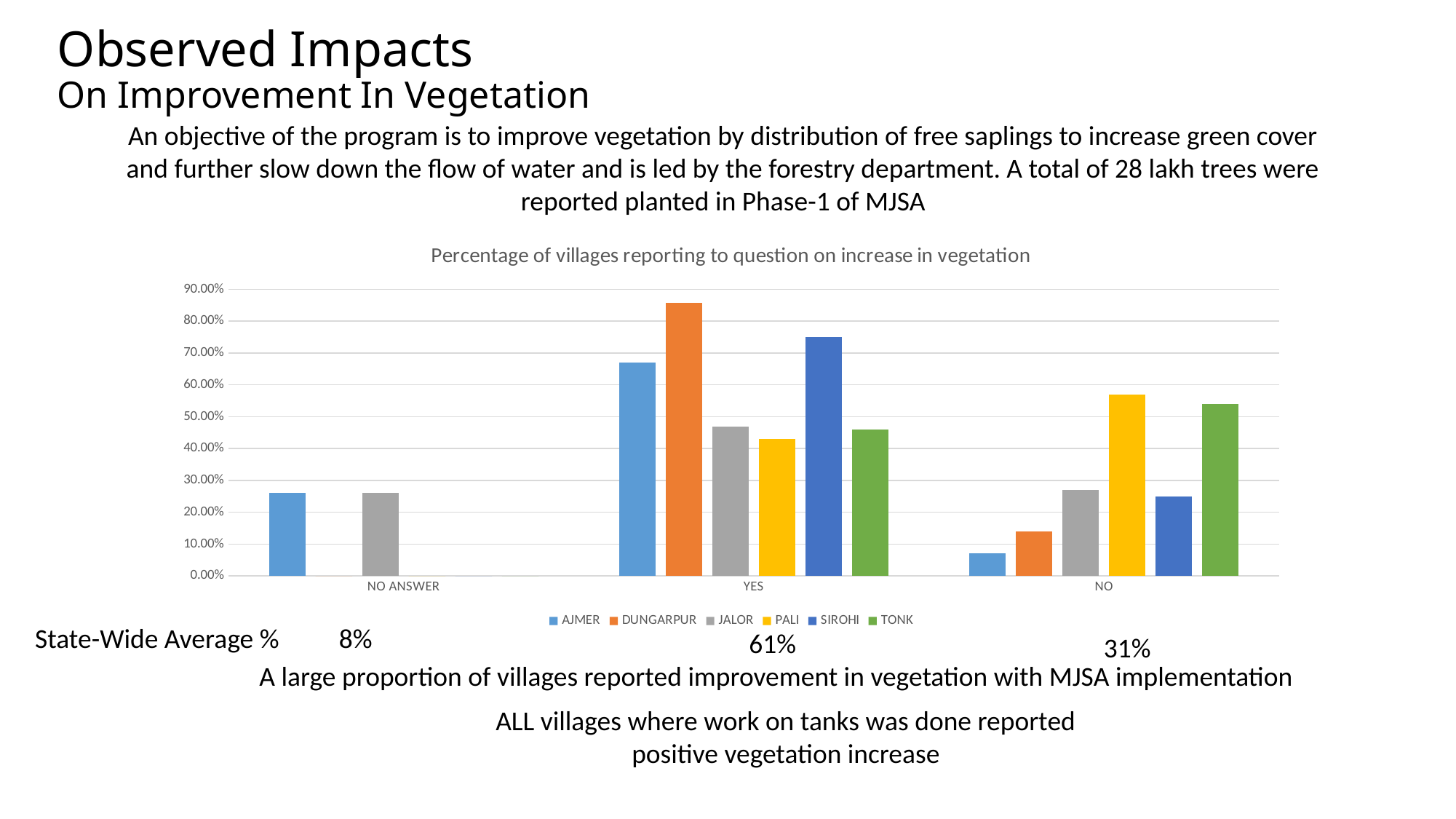
Is the value for JALOR in the YES category greater or less than 50.00%? less Which district has the lowest bar in the NO category? AJMER What kind of chart is shown on the slide? Bar chart Which district has the highest bar in the YES category? DUNGARPUR In the NO category, which is larger: the value for PALI or the value for DUNGARPUR? PALI How many response categories are shown on the x axis of the chart? 3 What is the title of the chart? Percentage of villages reporting to question on increase in vegetation Is the value for AJMER in the NO ANSWER category greater or less than 30.00%? less How many series does the legend of the chart list? 6 Is the value for DUNGARPUR in the YES category greater or less than 80.00%? greater In the YES category, which is larger: the value for AJMER or the value for SIROHI? SIROHI